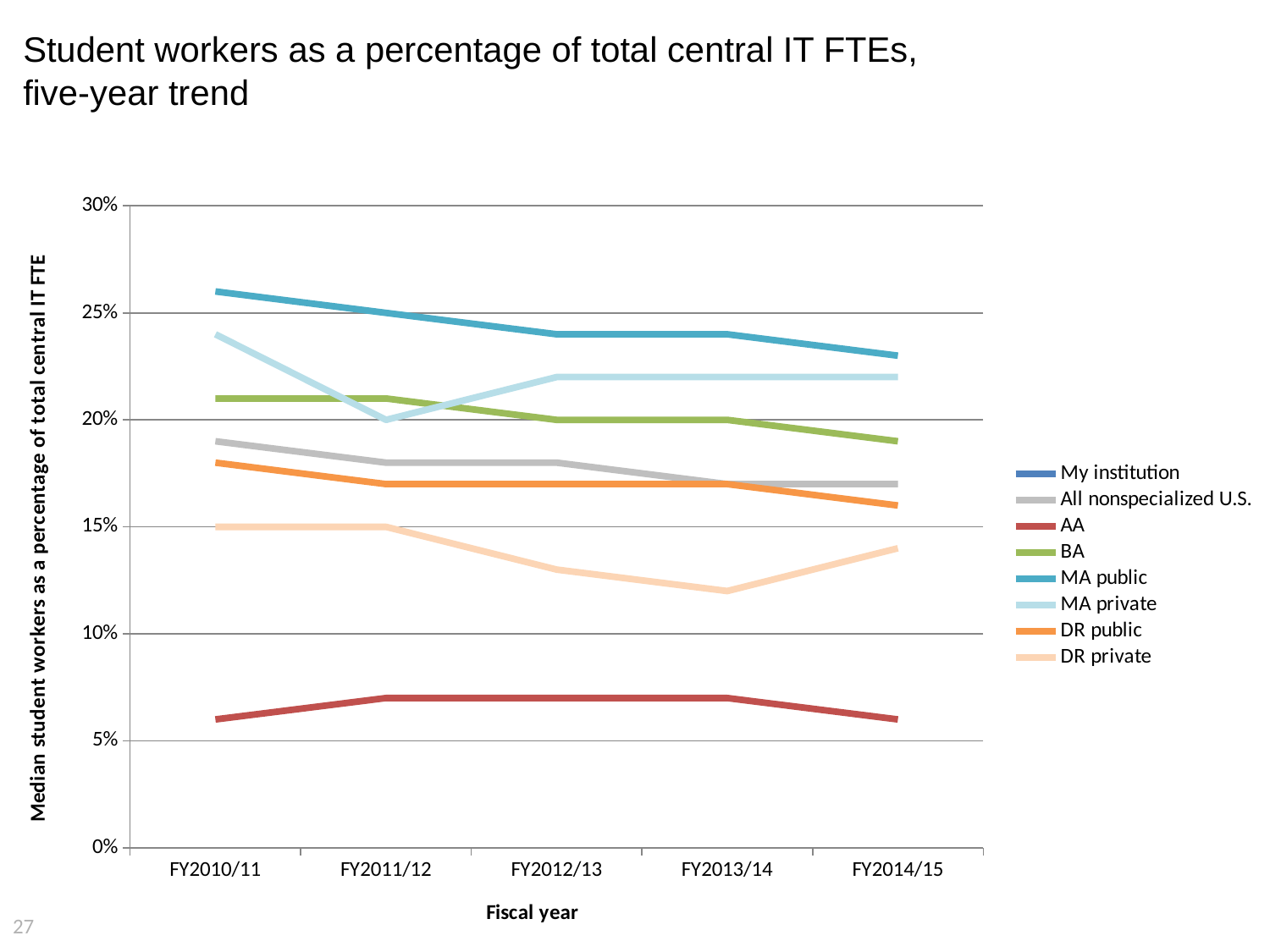
What is the value for MA public in FY2011/12? 25% What is the title of the x axis? Fiscal year Which series has the lowest value in FY2014/15? AA What is the value for DR private in FY2010/11? 15% Is the value for MA public in FY2010/11 greater or less than 25%? greater How many fiscal years are shown on the x axis? 5 Does the MA public line rise or fall from FY2010/11 to FY2014/15? fall How many series does the legend list? 8 Is the value for AA in FY2010/11 greater or less than 10%? less Which series has the highest value in FY2010/11? MA public What is the value for BA in FY2012/13? 20% What kind of chart is shown on the slide? line chart